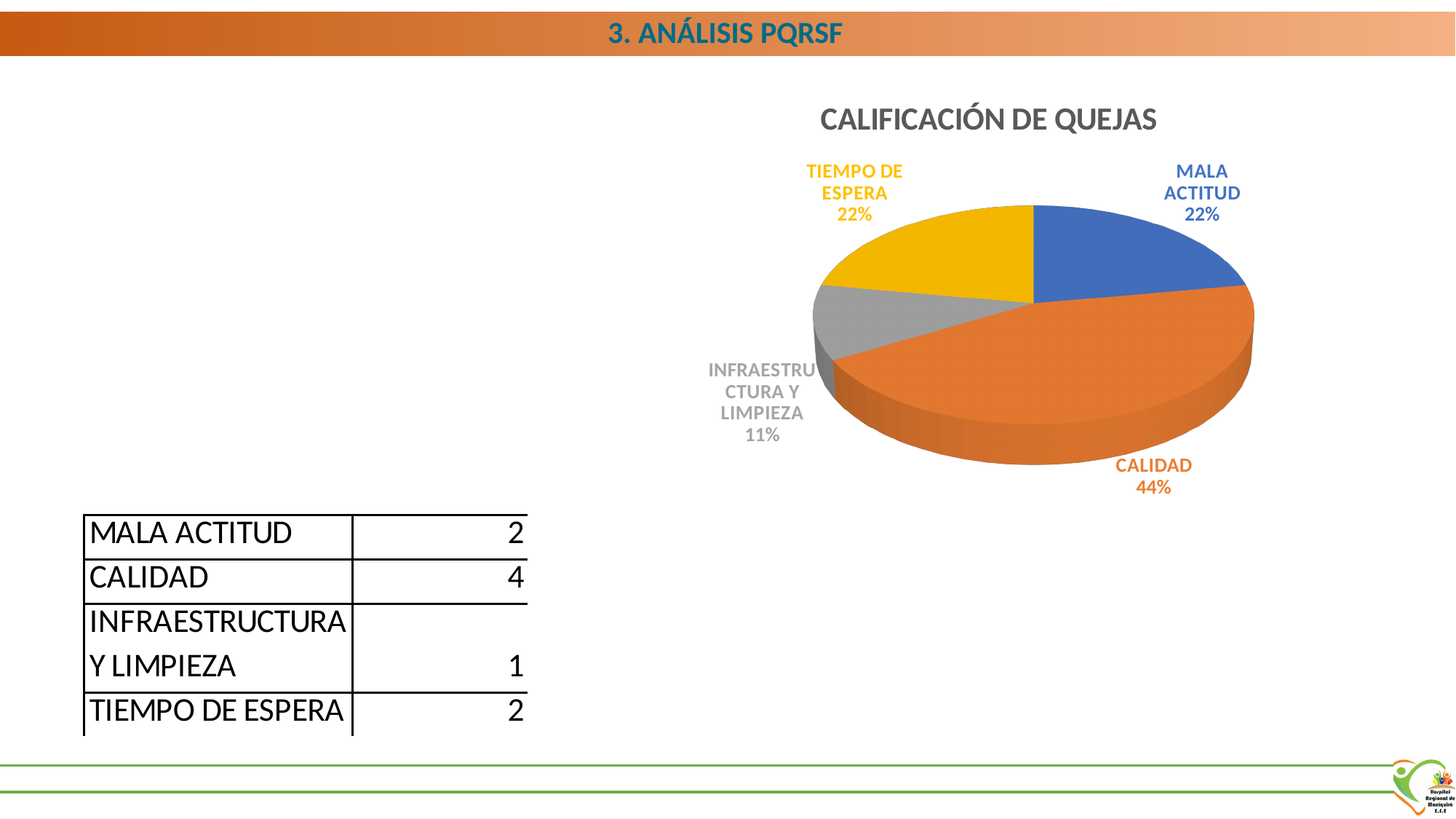
What percentage is shown for MALA ACTITUD? 22% What share of the pie does CALIDAD represent? 44% What percentage is shown for TIEMPO DE ESPERA? 22% What share of the pie does INFRAESTRUCTURA Y LIMPIEZA represent? 11% What is the difference in percentage points between CALIDAD and INFRAESTRUCTURA Y LIMPIEZA? 33 What colour is the CALIDAD slice? Orange Which category has the largest slice of the pie? CALIDAD What is the title of the chart? CALIFICACIÓN DE QUEJAS Which is larger, the share for CALIDAD or the share for MALA ACTITUD? CALIDAD How many categories are shown in the pie chart? 4 What kind of chart is shown on the slide? Pie chart Which category has the smallest slice of the pie? INFRAESTRUCTURA Y LIMPIEZA